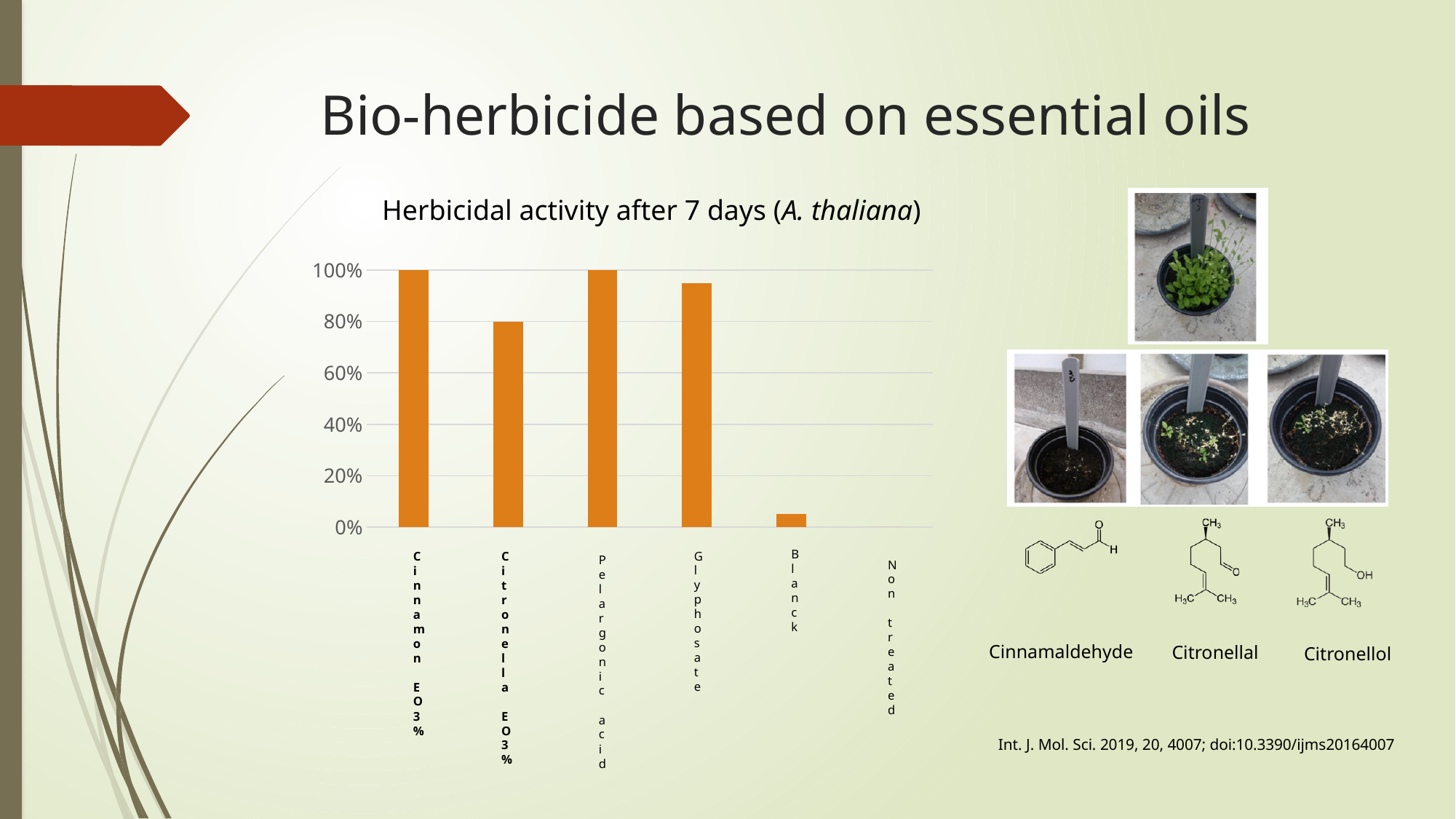
Is the value for Glyphosate greater or less than 80%? greater Is the value for Blanck greater or less than 20%? less What is the difference between the values for Cinnamon EO3% and Citronella EO3%? 20% What is the herbicidal activity value for Citronella EO3%? 80% What is the herbicidal activity value for Cinnamon EO3%? 100% What is the herbicidal activity value for Pelargonic acid? 100% What colour are the bars in the chart? orange How many categories are shown on the x axis of the chart? 6 Which has a higher herbicidal activity, Citronella EO3% or Glyphosate? Glyphosate What kind of chart is shown on the slide? bar chart Which category has the lowest herbicidal activity? Non treated What is the title of the chart? Herbicidal activity after 7 days (A. thaliana)